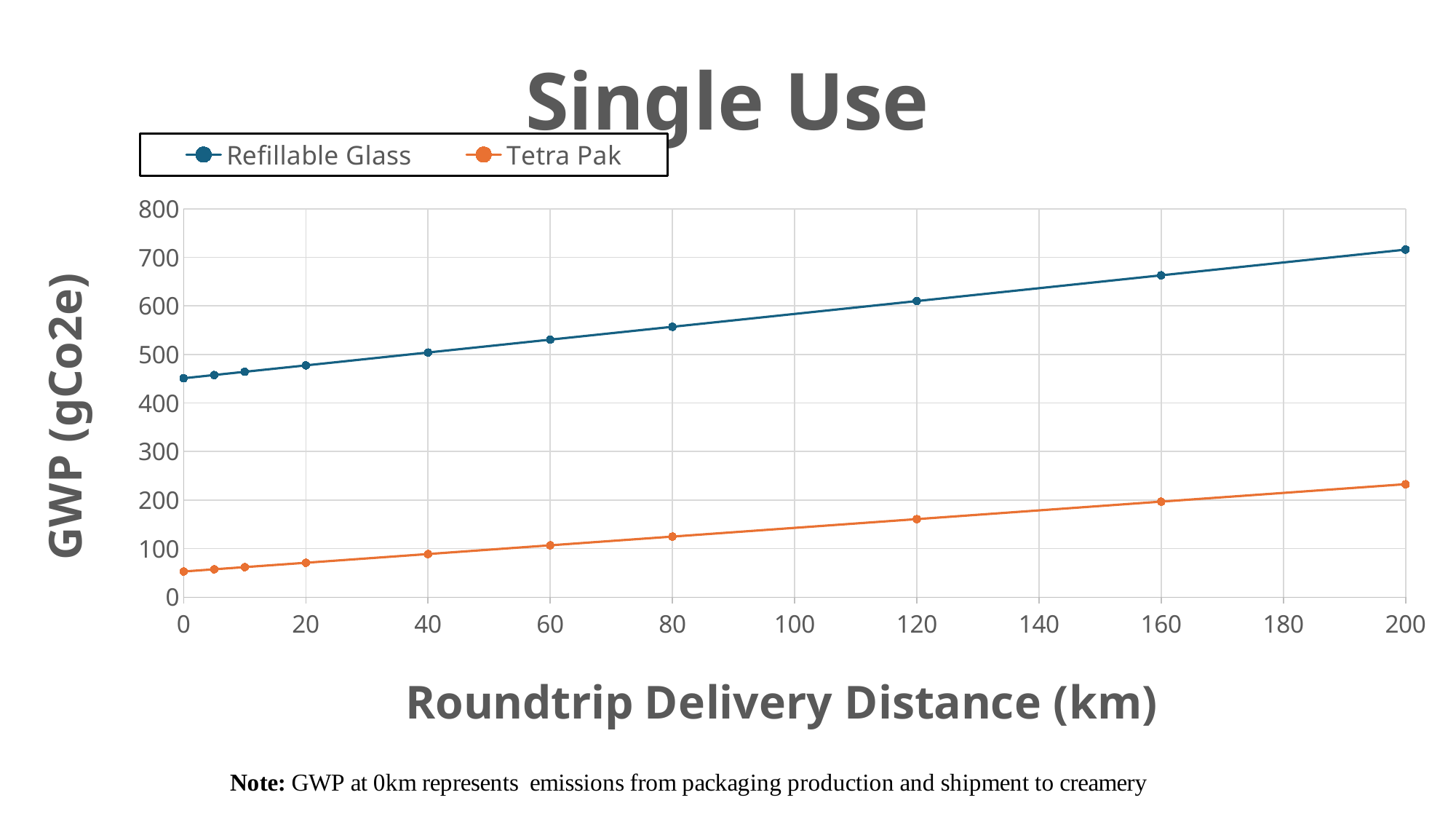
Do the Tetra Pak values rise or fall as the roundtrip delivery distance increases? rise Do the Refillable Glass values rise or fall as the roundtrip delivery distance increases? rise What kind of chart is shown on the slide? line chart What is the title of the chart? Single Use Is the GWP value for Tetra Pak at 0 km greater or less than 100? less What is the label of the x axis? Roundtrip Delivery Distance (km) Is the GWP value for Refillable Glass at 200 km greater or less than 700? greater How many data points are plotted for the Tetra Pak series? 10 Is the GWP value for Refillable Glass at 0 km greater or less than 400? greater Which series has the higher GWP at 200 km, Refillable Glass or Tetra Pak? Refillable Glass How many series does the legend list? 2